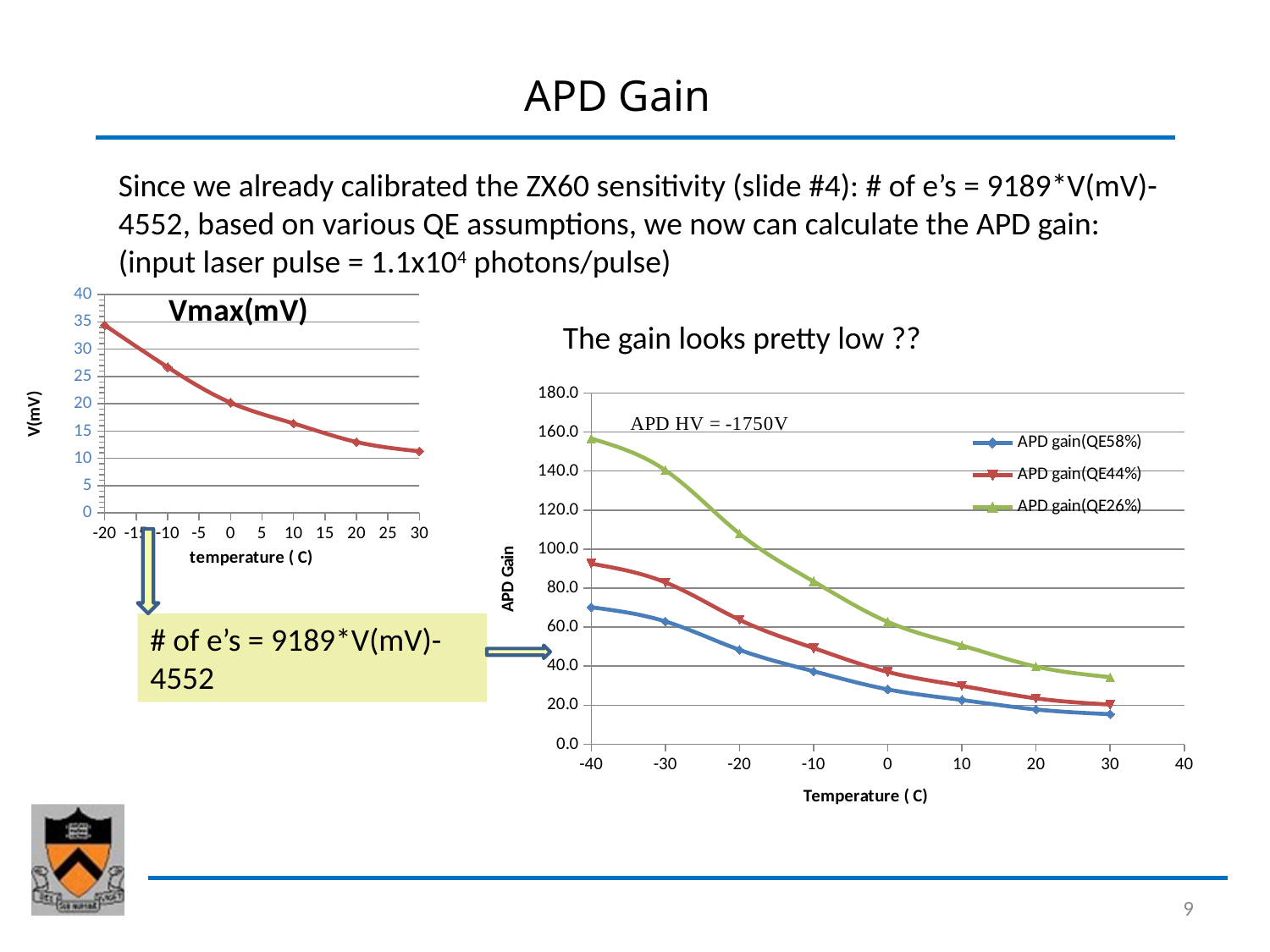
In the Vmax(mV) chart on the left, do the values rise or fall as temperature increases? fall In the Vmax(mV) chart on the left, how many data points are plotted? 6 What kind of chart is the Vmax(mV) chart on the left? line chart In the APD Gain chart on the right, which series has the highest gain at -40 C? APD gain(QE26%) In the Vmax(mV) chart on the left, is the value at 30 C greater or less than 15? less In the APD Gain chart on the right, how many temperature points are plotted for each series? 8 In the Vmax(mV) chart on the left, is the value at -20 C greater or less than 30? greater In the APD Gain chart on the right, is the APD gain(QE26%) value at -40 C greater or less than 140? greater In the APD Gain chart on the right, what APD HV value is noted on the chart? -1750V In the APD Gain chart on the right, how many series does the legend list? 3